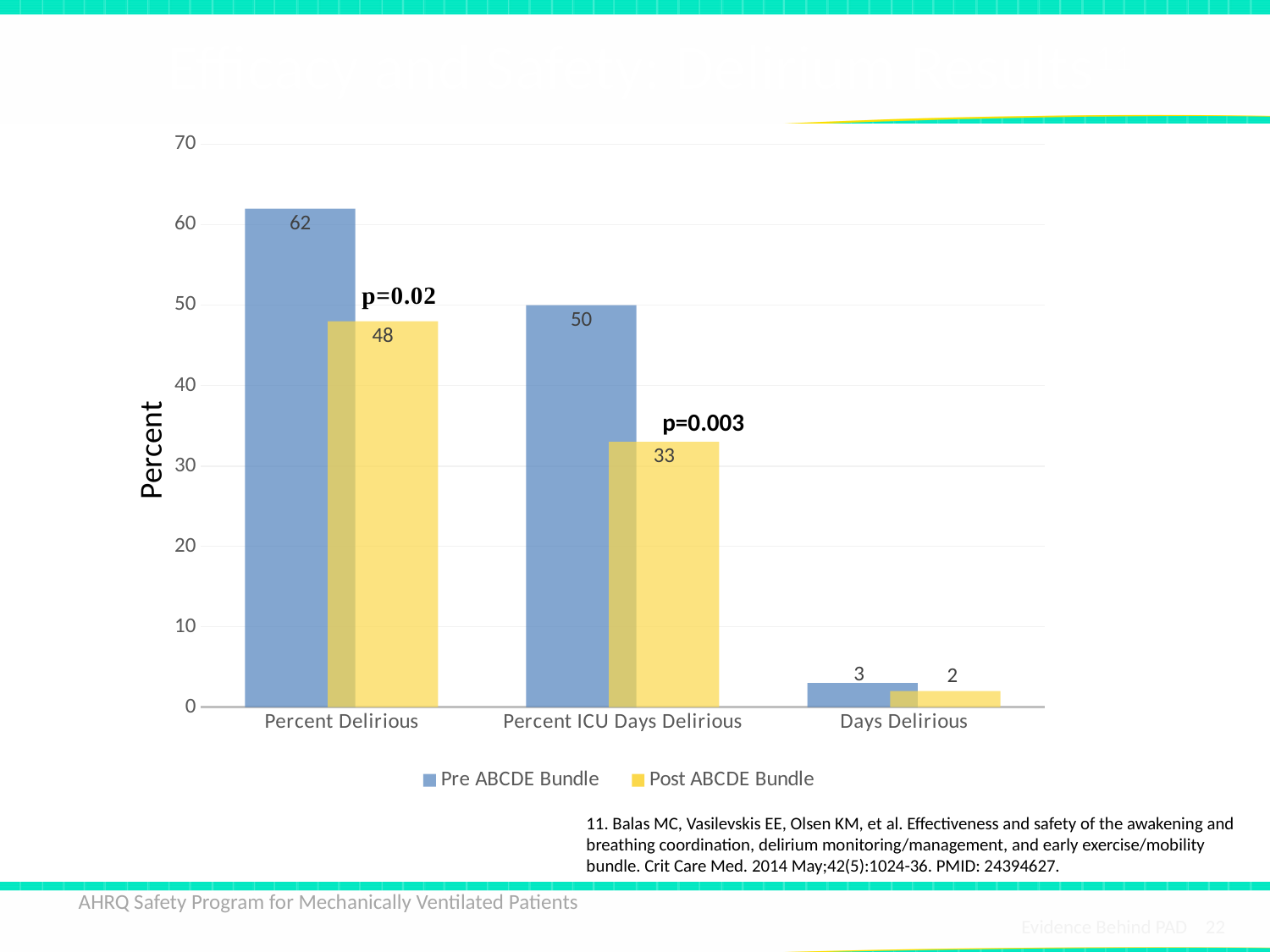
How many categories are shown on the x axis? 3 Which category has the lowest Post ABCDE Bundle value? Days Delirious How many series does the legend list? 2 Which is larger for Percent Delirious: the Pre ABCDE Bundle value or the Post ABCDE Bundle value? Pre ABCDE Bundle What is the label on the vertical axis? Percent What is the Pre ABCDE Bundle value for Percent Delirious? 62 What kind of chart is shown on the slide? Bar chart What is the difference between the Pre and Post ABCDE Bundle values for Percent ICU Days Delirious? 17 What is the Post ABCDE Bundle value for Days Delirious? 2 Which category has the highest Pre ABCDE Bundle value? Percent Delirious What is the Post ABCDE Bundle value for Percent ICU Days Delirious? 33 What is the difference between the Pre and Post ABCDE Bundle values for Percent Delirious? 14